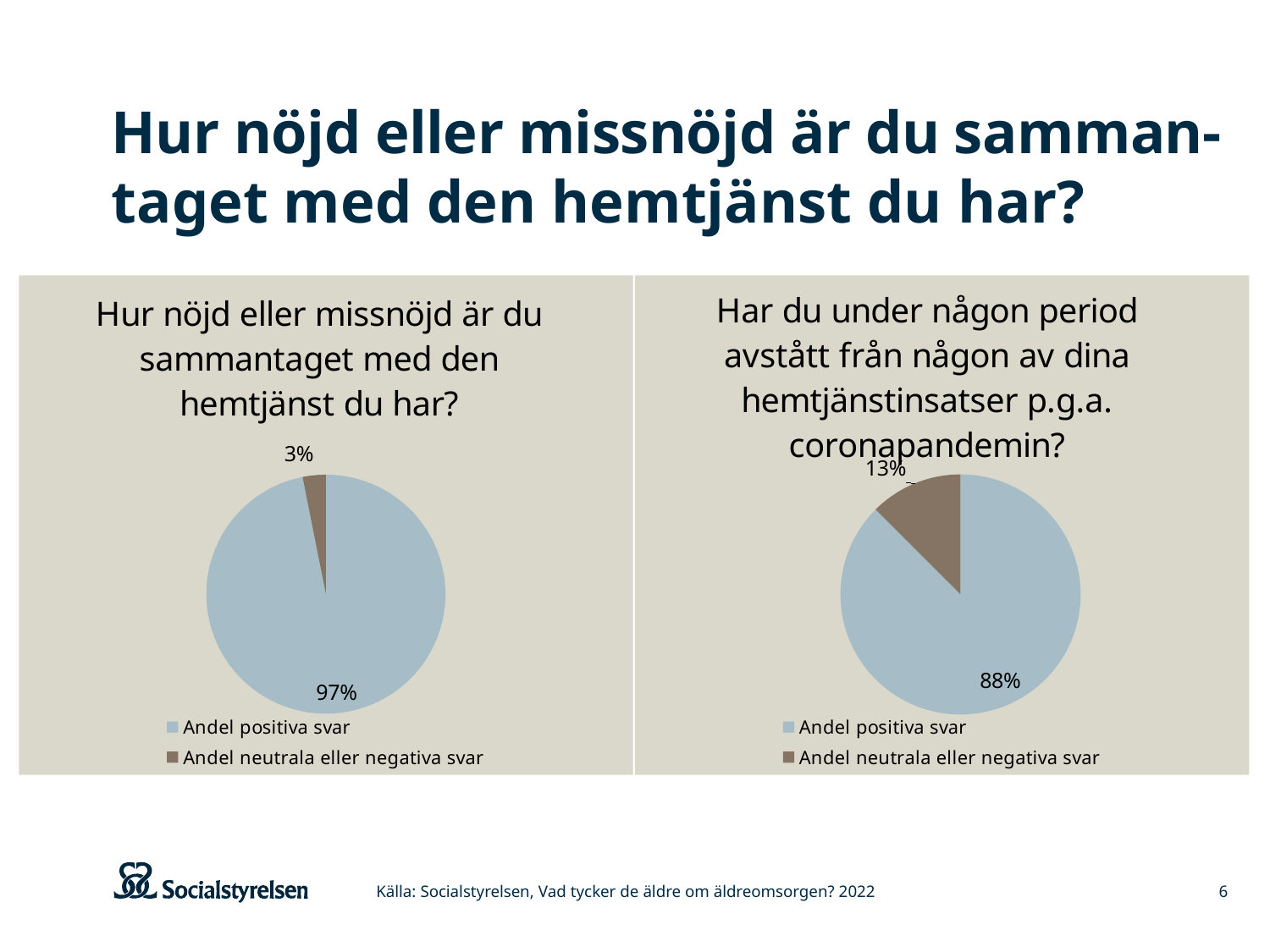
Which chart has the larger 'Andel neutrala eller negativa svar' share, the left or the right pie chart? The right pie chart In the left pie chart, which slice is the largest? Andel positiva svar How many entries does the legend of the left pie chart list? 2 How many slices does the right pie chart have? 2 In the right pie chart, what is the value for 'Andel neutrala eller negativa svar'? 13% What is the difference between the 'Andel positiva svar' values in the left and right pie charts? 9 percentage points In the left pie chart, what is the value for 'Andel neutrala eller negativa svar'? 3% What is the title of the right pie chart? Har du under någon period avstått från någon av dina hemtjänstinsatser p.g.a. coronapandemin? What type of chart is used on the left side of the slide? Pie chart In the right pie chart, which slice is the smallest? Andel neutrala eller negativa svar In the right pie chart, what is the value for 'Andel positiva svar'? 88% In the left pie chart, what is the value for 'Andel positiva svar'? 97%